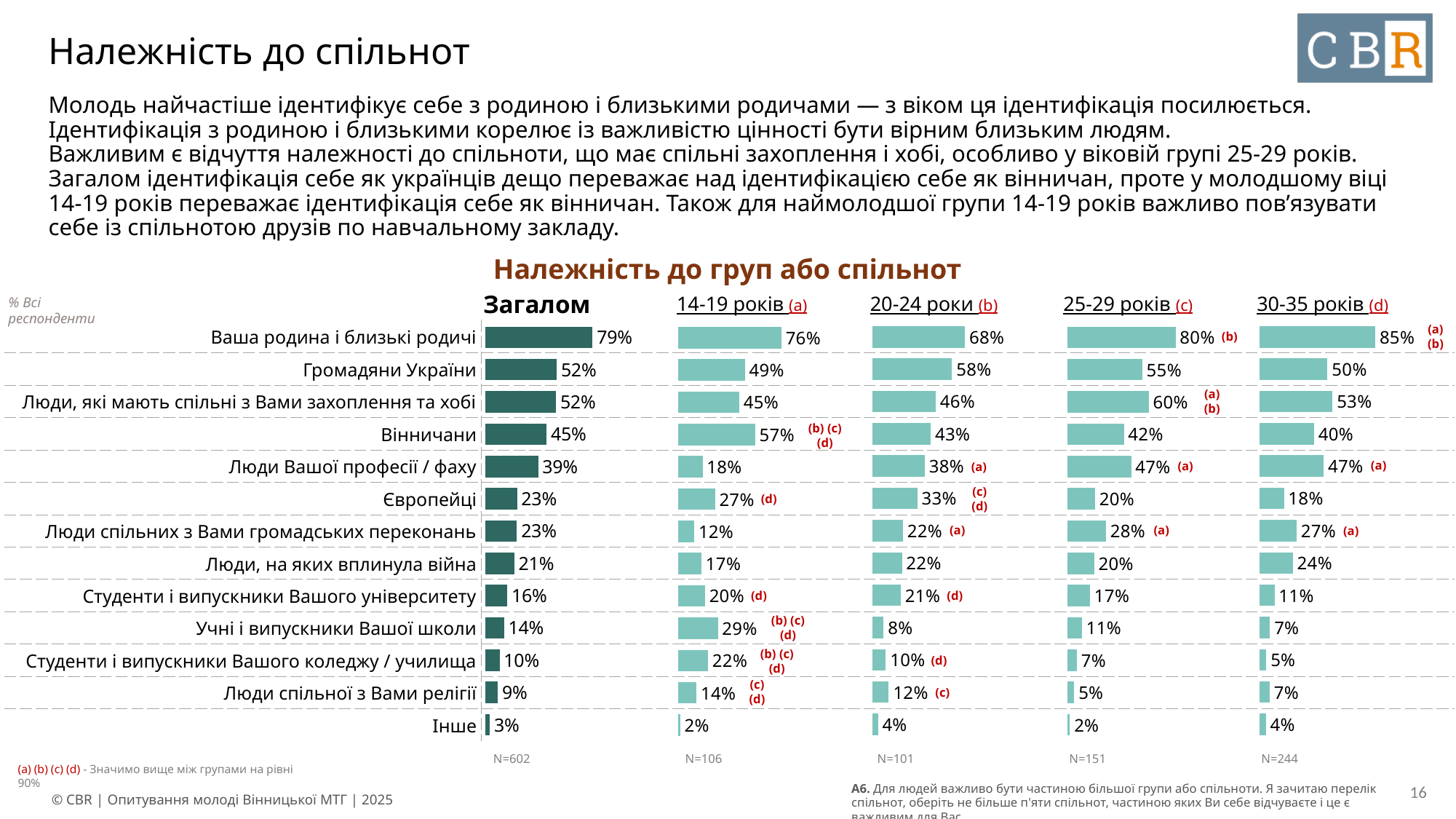
What is the difference between the "30-35 років" and "14-19 років" values for "Ваша родина і близькі родичі"? 9% What type of chart is shown on the slide? Bar chart Which is larger for "Учні і випускники Вашої школи": the "14-19 років" value or the "20-24 роки" value? 14-19 років What is the value for "Вінничани" in the "14-19 років" column? 57% What is the value for "Ваша родина і близькі родичі" in the "Загалом" column? 79% Which category has the lowest value in the "Загалом" column? Інше What is the value for "Люди, які мають спільні з Вами захоплення та хобі" in the "25-29 років" column? 60% What is the value for "Європейці" in the "20-24 роки" column? 33% What is the title of the chart? Належність до груп або спільнот Which category has the highest value in the "30-35 років" column? Ваша родина і близькі родичі What is the sample size (N) shown for the "Загалом" column? N=602 How many categories are listed in the chart? 13